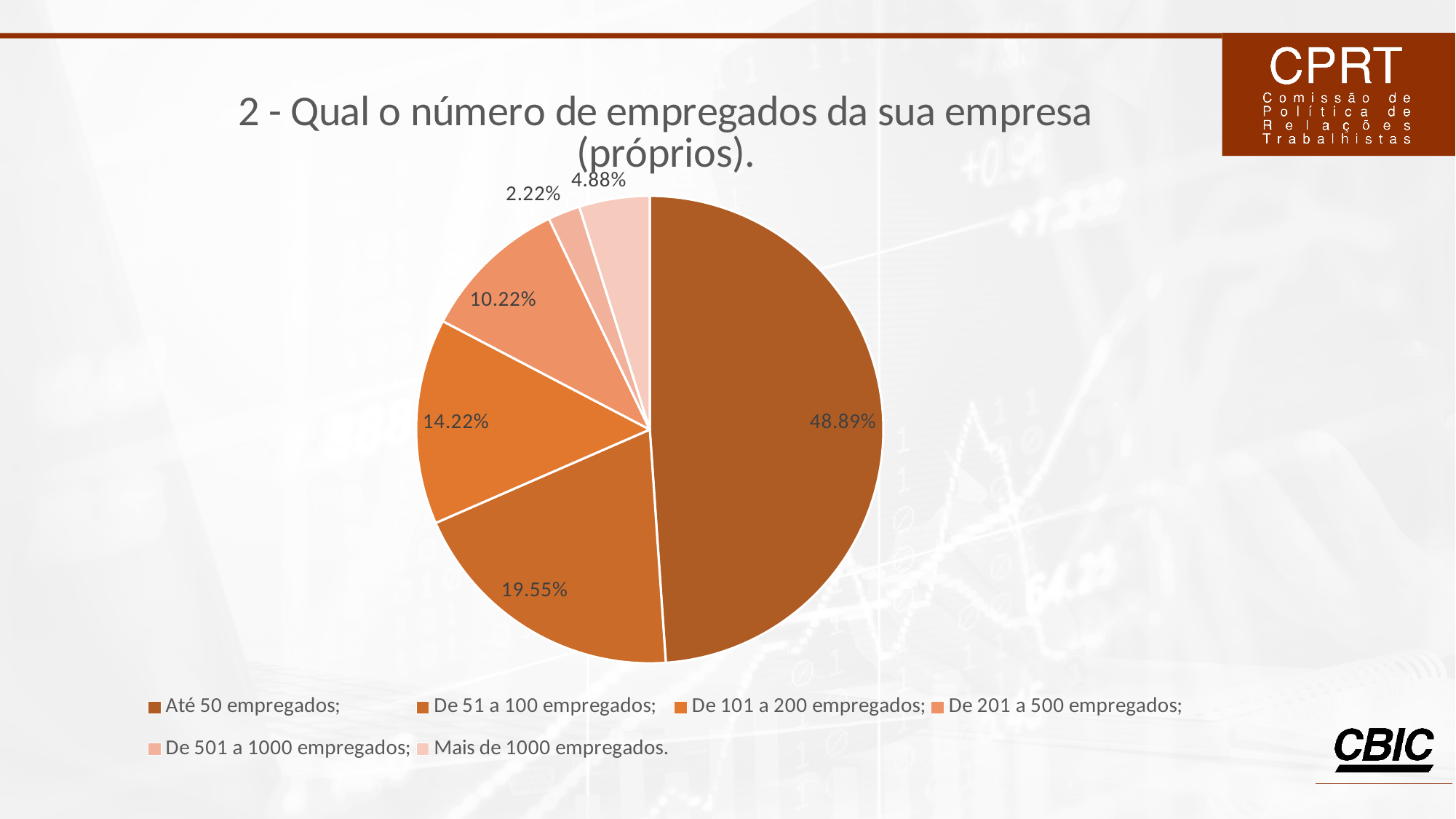
What is the difference in percentage points between "Até 50 empregados" and "De 51 a 100 empregados"? 29.34 What share of the pie corresponds to "Até 50 empregados"? 48.89% What percentage is shown for "De 101 a 200 empregados"? 14.22% Which category has the largest slice of the pie? Até 50 empregados What is the title of the chart? 2 - Qual o número de empregados da sua empresa (próprios). What percentage is shown for "Mais de 1000 empregados"? 4.88% Which category has the smallest slice of the pie? De 501 a 1000 empregados What kind of chart is shown on the slide? pie chart What percentage is shown for "De 201 a 500 empregados"? 10.22% Which is larger: the slice for "De 201 a 500 empregados" or the slice for "Mais de 1000 empregados"? De 201 a 500 empregados How many categories does the legend list? 6 What percentage is shown for "De 51 a 100 empregados"? 19.55%